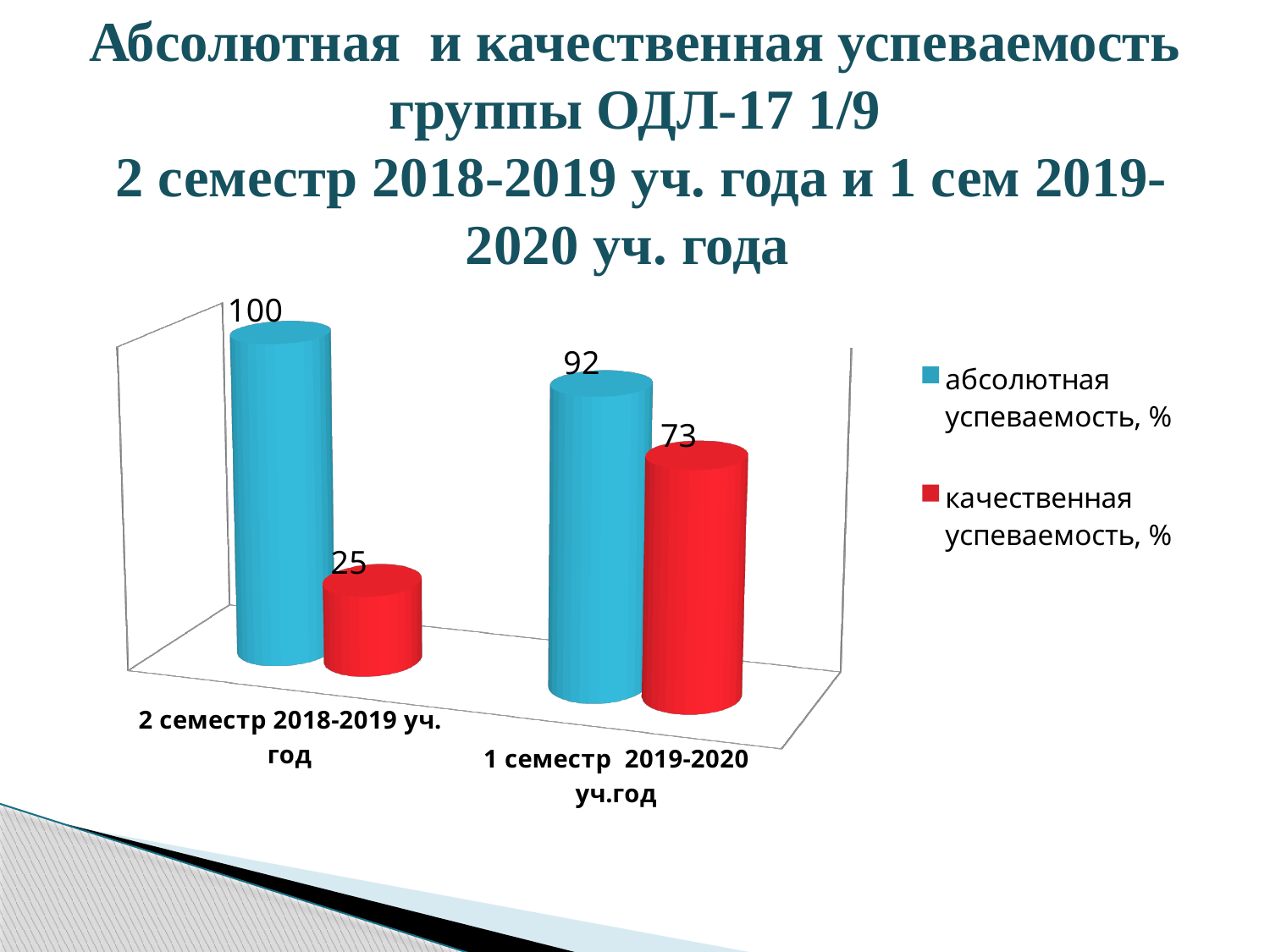
By how much did качественная успеваемость, % change from 2 семестр 2018-2019 уч. год to 1 семестр 2019-2020 уч.год? 48 What is the value of абсолютная успеваемость, % for 2 семестр 2018-2019 уч. год? 100 What is the value of абсолютная успеваемость, % for 1 семестр 2019-2020 уч.год? 92 Which is larger: абсолютная успеваемость, % for 1 семестр 2019-2020 уч.год or качественная успеваемость, % for 1 семестр 2019-2020 уч.год? абсолютная успеваемость, % What kind of chart is shown on the slide? bar chart What is the value of качественная успеваемость, % for 2 семестр 2018-2019 уч. год? 25 How many categories are shown on the x axis? 2 Which category has the highest value for качественная успеваемость, %? 1 семестр 2019-2020 уч.год How many series does the legend list? 2 What is the value of качественная успеваемость, % for 1 семестр 2019-2020 уч.год? 73 Which category has the lowest value for абсолютная успеваемость, %? 1 семестр 2019-2020 уч.год What is the difference between абсолютная успеваемость, % and качественная успеваемость, % for 2 семестр 2018-2019 уч. год? 75